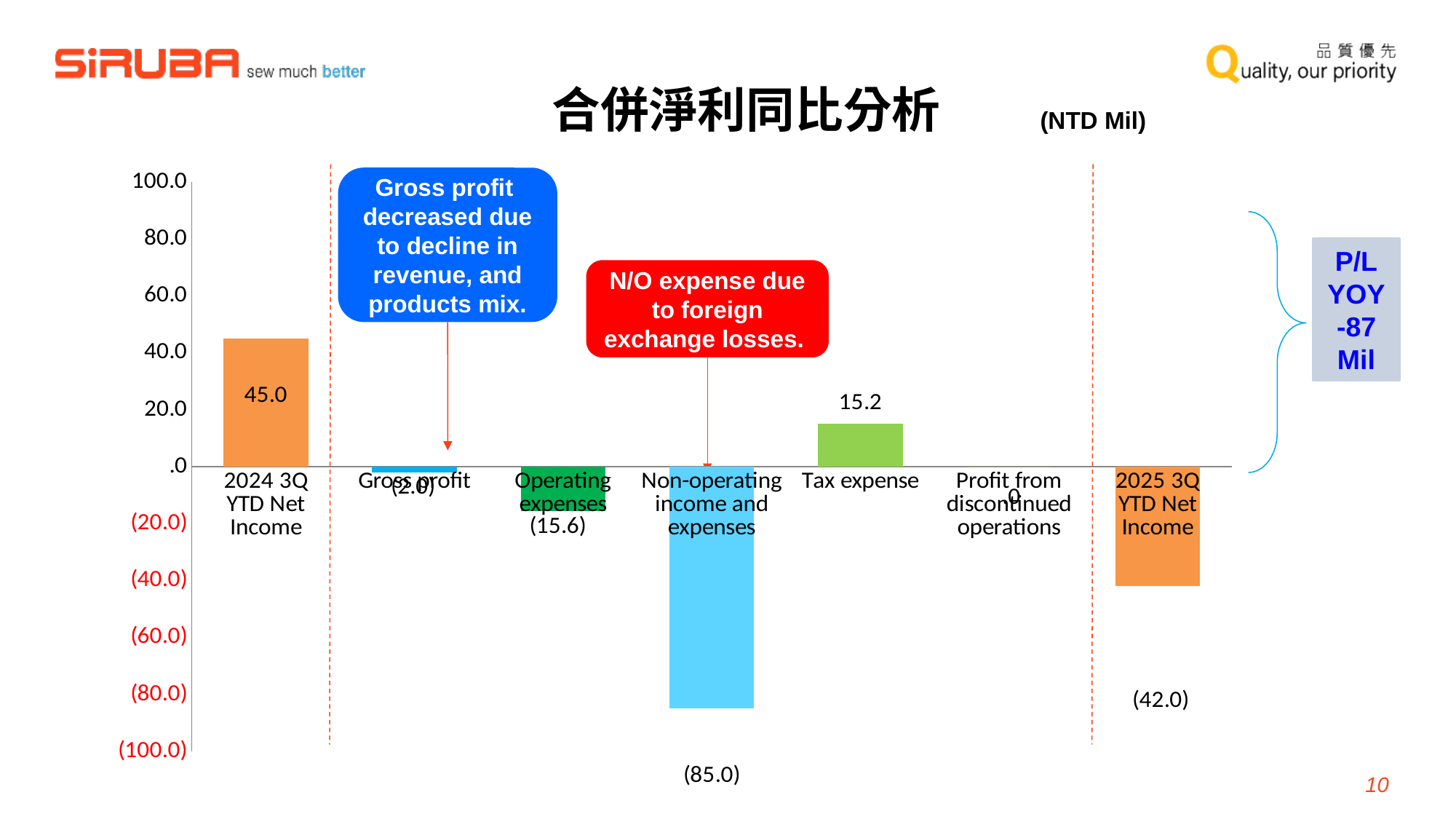
Is the bar for Non-operating income and expenses above or below (80.0) on the axis? below How many categories are shown on the x axis? 7 What unit is stated next to the chart title? NTD Mil What is the value shown for Tax expense? 15.2 What is the value shown for Operating expenses? (15.6) What is the value shown for 2024 3Q YTD Net Income? 45.0 Which category has the highest positive value? 2024 3Q YTD Net Income Which category has the largest negative bar? Non-operating income and expenses What is the value shown for Profit from discontinued operations? 0 What is the value shown for 2025 3Q YTD Net Income? (42.0) What is the value shown for Non-operating income and expenses? (85.0) What kind of chart is shown on the slide? Bar chart